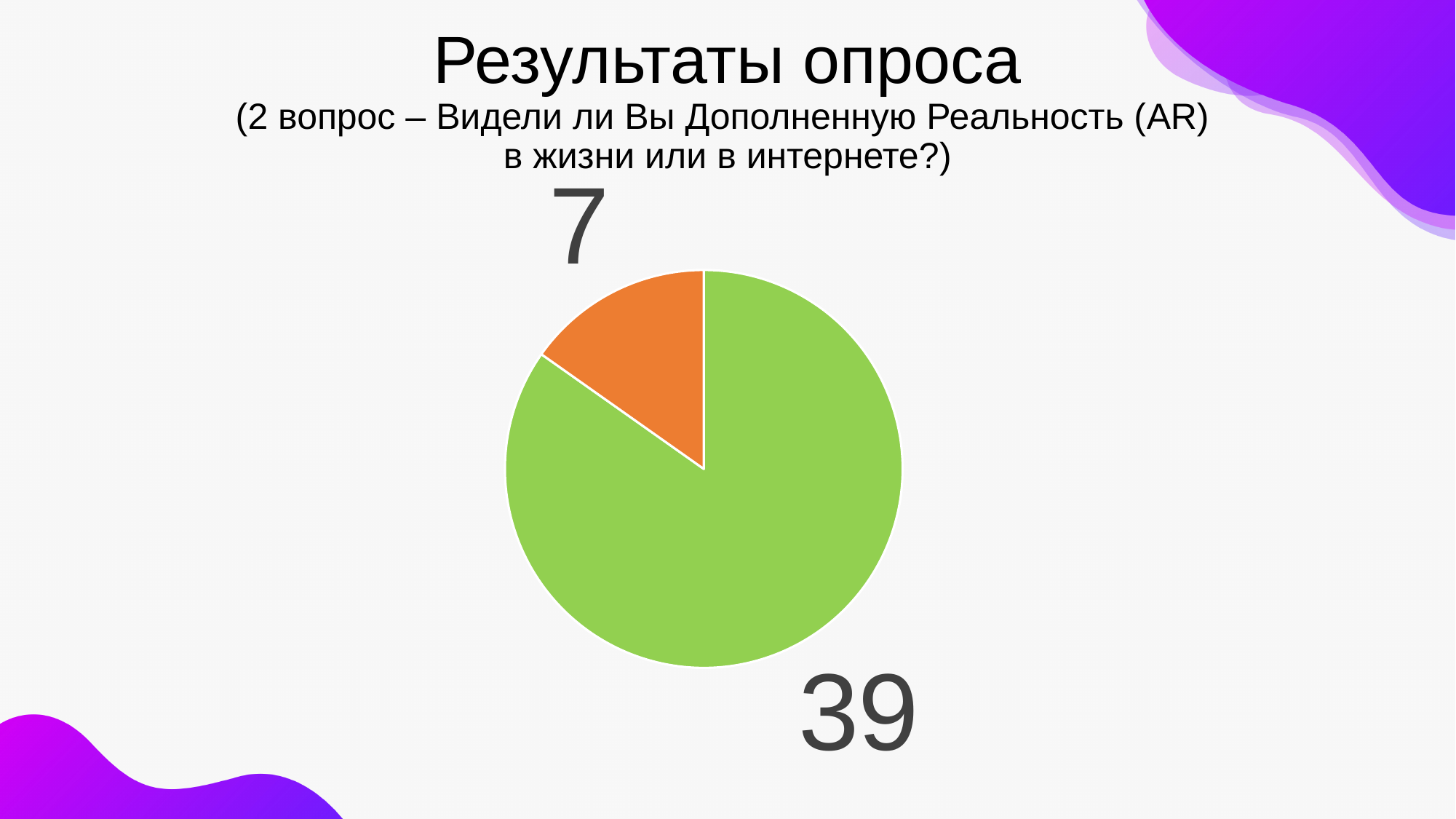
Which slice of the pie chart is the largest? the green slice What kind of chart is shown on the slide? pie chart What value is shown for the orange slice of the pie chart? 7 What value is shown for the green slice of the pie chart? 39 What colour is the largest slice of the pie chart? green Which is larger, the green slice or the orange slice? the green slice What is the title of the slide containing the pie chart? Результаты опроса Which slice of the pie chart is the smallest? the orange slice What is the difference between the green slice value and the orange slice value? 32 What is the total of the two slice values in the pie chart? 46 How many slices does the pie chart have? 2